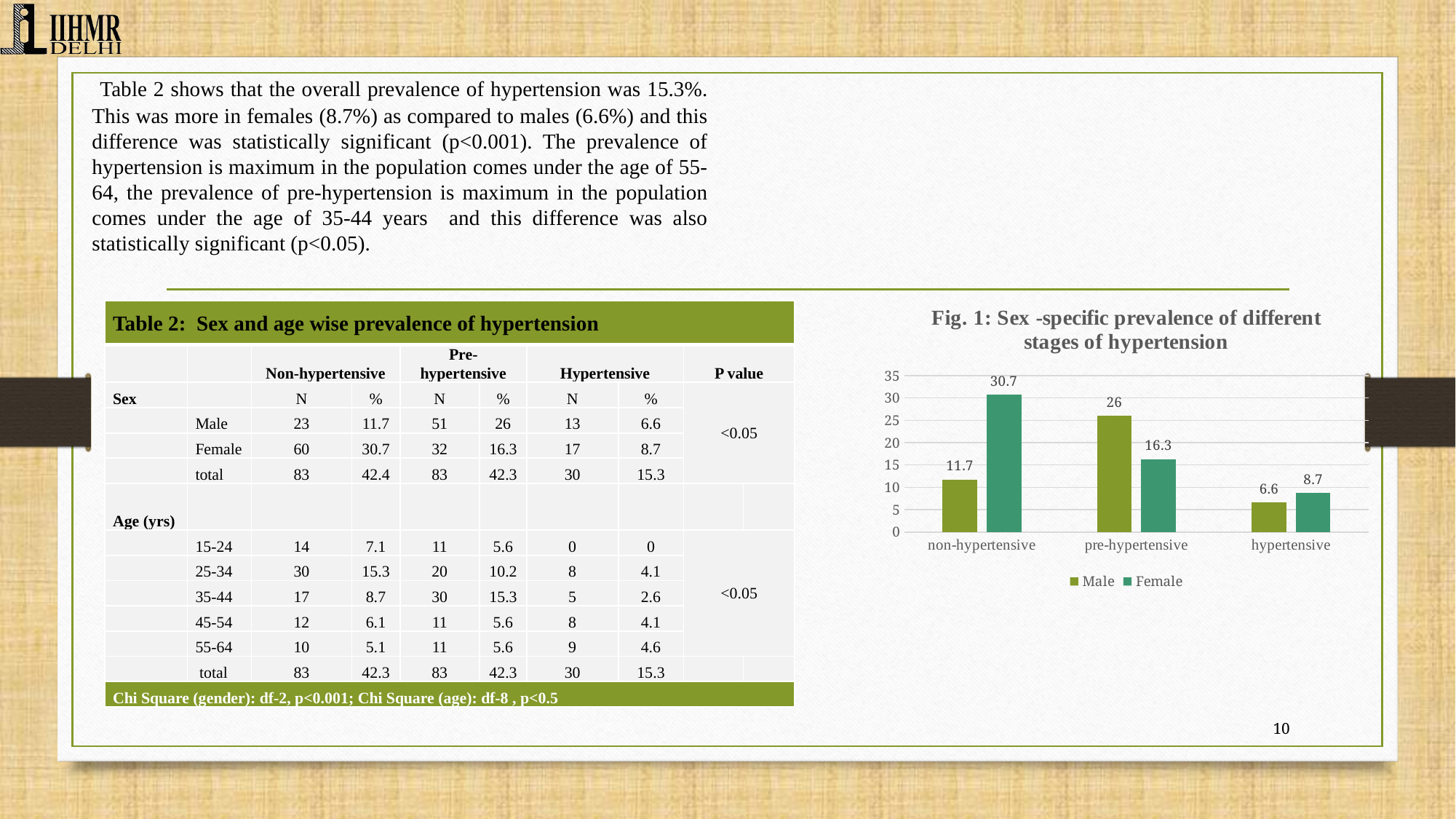
Is the Male value for pre-hypertensive in Fig. 1 greater or less than 20? greater Which category has the highest Female value in Fig. 1? non-hypertensive How many series does the legend of Fig. 1 list? 2 What is the Female value for pre-hypertensive in Fig. 1? 16.3 What is the Female value for hypertensive in Fig. 1? 8.7 What kind of chart is Fig. 1? bar chart Which category has the lowest Male value in Fig. 1? hypertensive What is the title of the chart on the slide? Fig. 1: Sex -specific prevalence of different stages of hypertension In Fig. 1, which is larger for pre-hypertensive: the Male value or the Female value? Male What is the Male value for non-hypertensive in Fig. 1? 11.7 What is the difference between the Female and Male values for non-hypertensive in Fig. 1? 19 How many categories are shown on the x axis of Fig. 1? 3